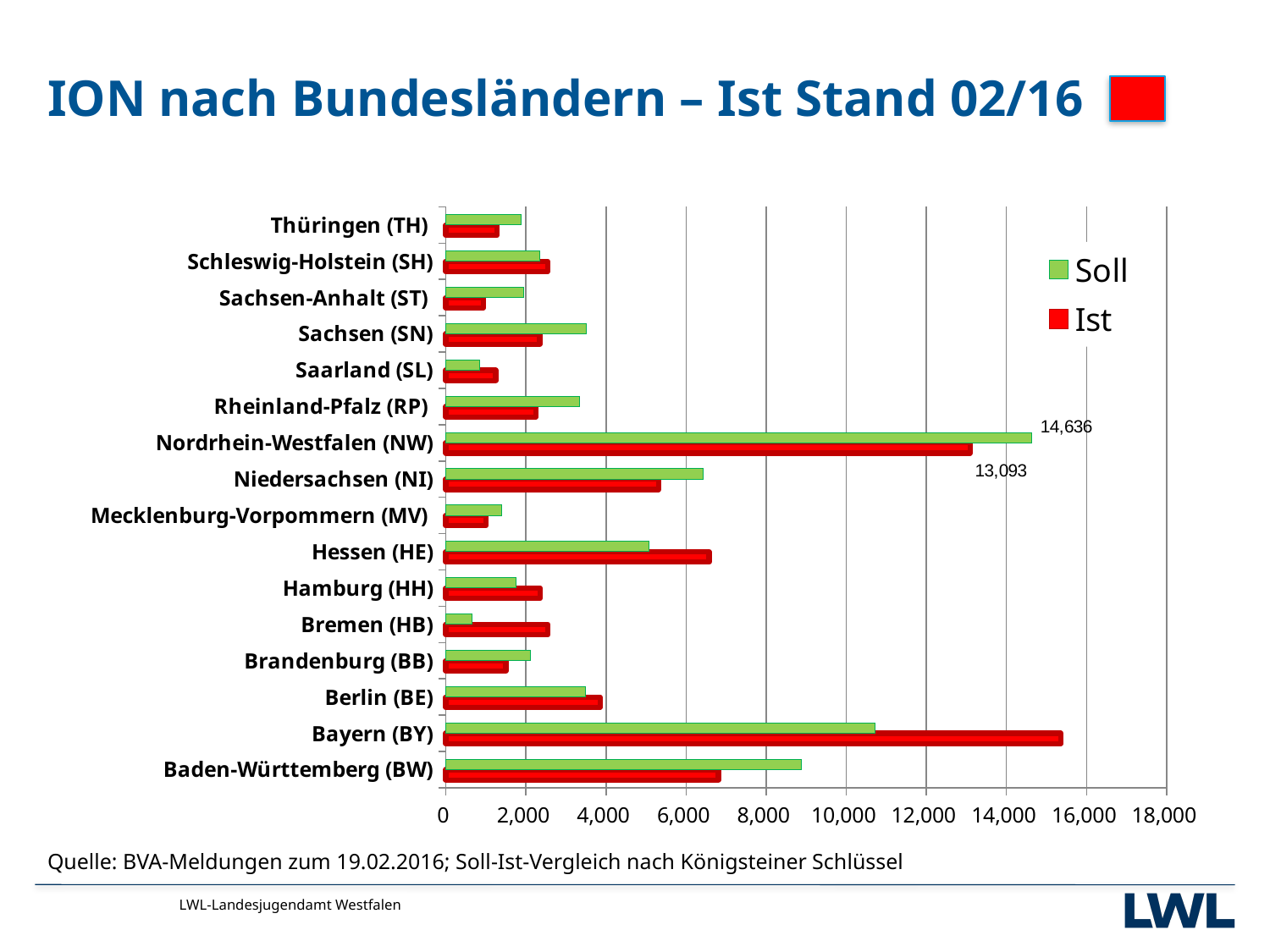
Is the Soll value for Baden-Württemberg (BW) greater or less than 8,000? greater How many Bundesländer are shown on the chart? 16 What is the Soll value for Nordrhein-Westfalen (NW)? 14,636 For Bayern (BY), which is larger, the Soll value or the Ist value? Ist Is the Ist value for Bayern (BY) greater or less than 14,000? greater Which Bundesland has the highest Ist value? Bayern (BY) For Baden-Württemberg (BW), which is larger, the Soll value or the Ist value? Soll How many series does the legend list? 2 What is the Ist value for Nordrhein-Westfalen (NW)? 13,093 Which Bundesland has the highest Soll value? Nordrhein-Westfalen (NW) What is the difference between the Soll and Ist values for Nordrhein-Westfalen (NW)? 1,543 What kind of chart is shown on the slide? Bar chart